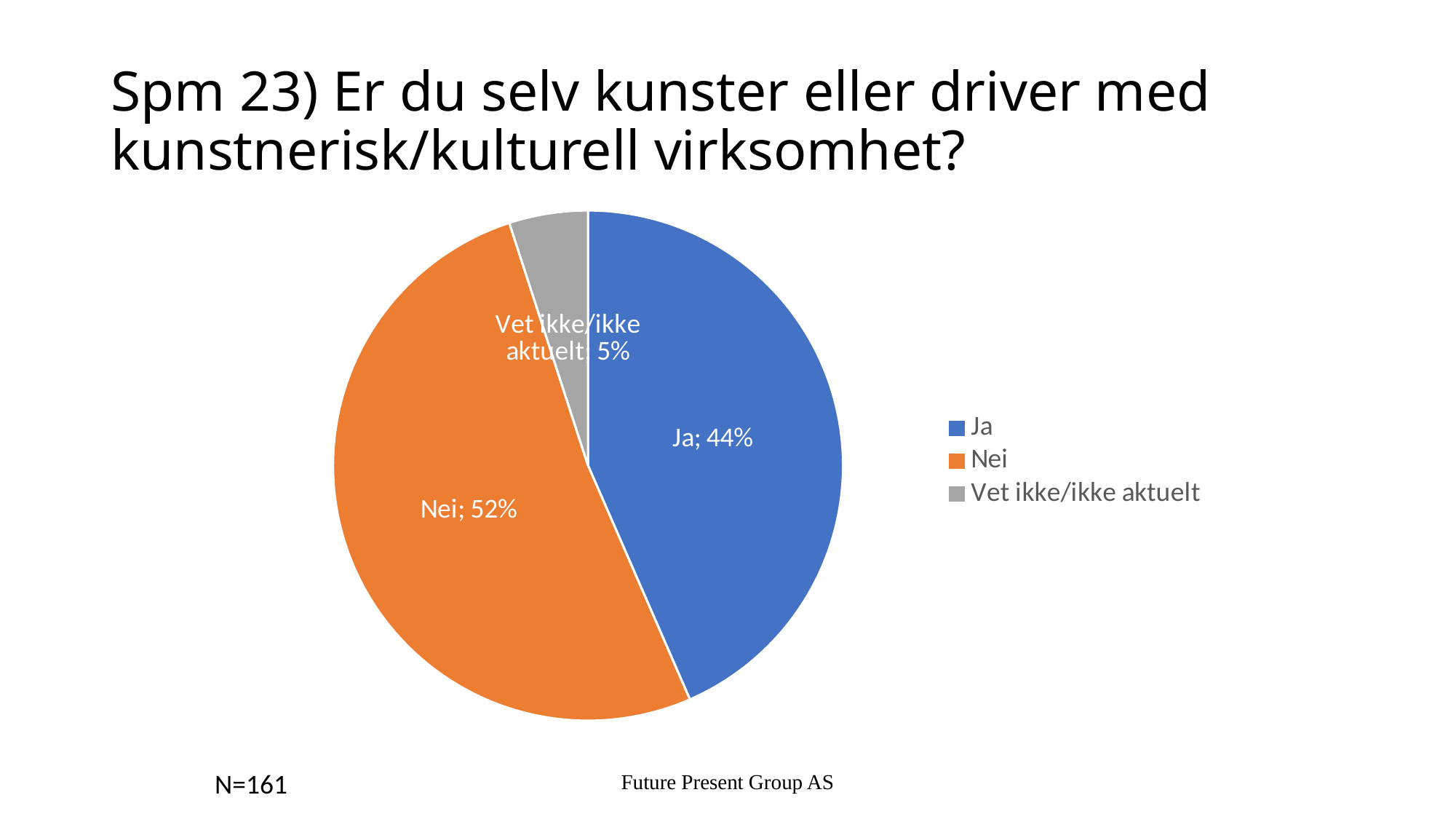
What type of chart is shown on the slide? pie chart What percentage of respondents answered "Nei"? 52% What is the sample size (N) shown on the slide? N=161 Which is larger, the share for "Ja" or the share for "Nei"? Nei Which answer category has the smallest share of the pie? Vet ikke/ikke aktuelt What colour is the "Nei" slice? orange What is the difference in percentage points between "Nei" and "Ja"? 8 How many slices does the pie chart have? 3 What percentage of respondents answered "Ja"? 44% What percentage of respondents answered "Vet ikke/ikke aktuelt"? 5% How many entries does the legend list? 3 Which answer category has the largest share of the pie? Nei